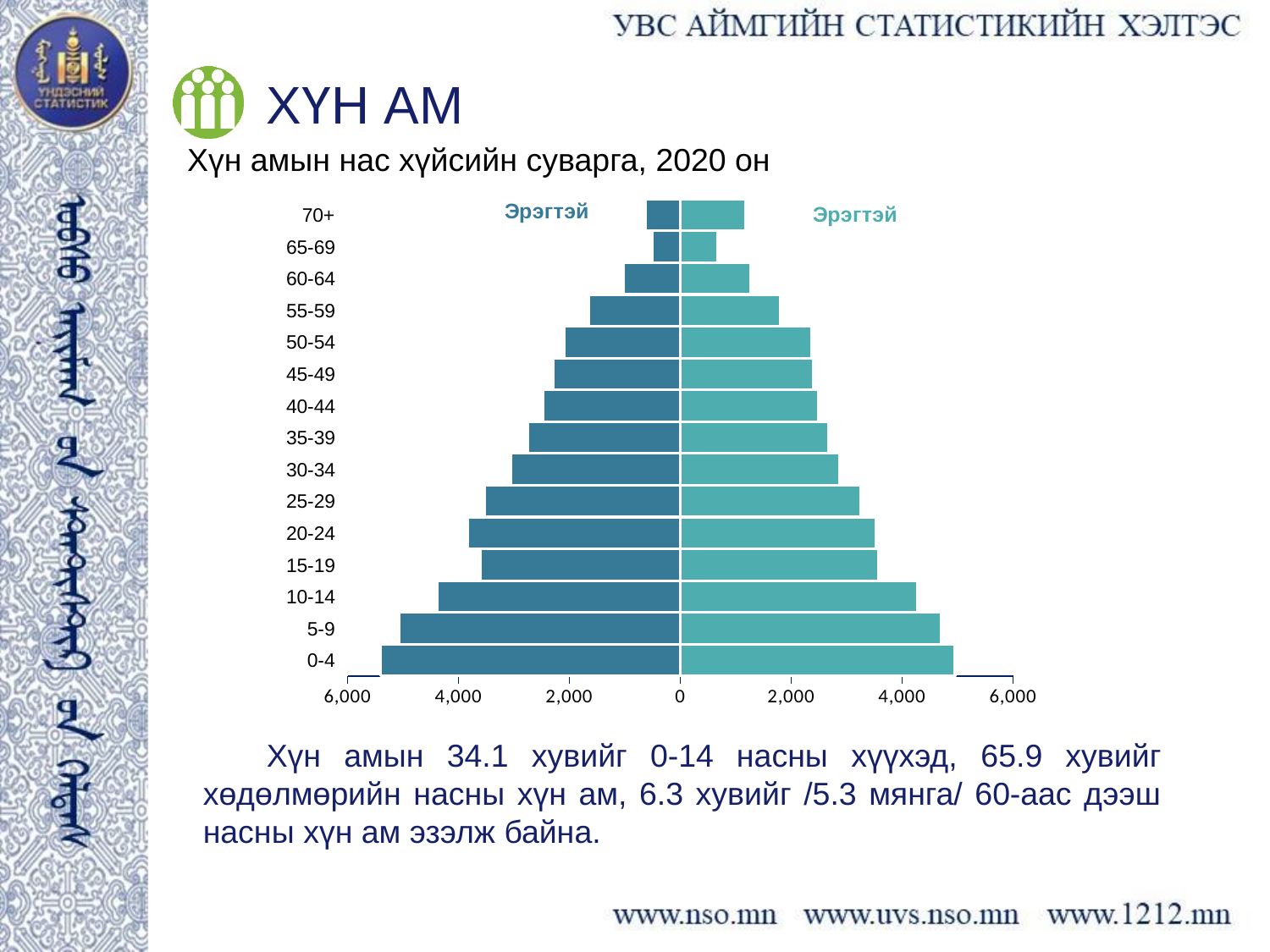
Which year is stated in the chart title? 2020 Do the bars generally get longer or shorter as the age groups increase from 0-4 to 70+? shorter What kind of chart is shown on the slide? bar chart Which age group has the shortest bar on the left (dark blue) side of the chart? 65-69 Which age group has the longest bar on the left (dark blue) side of the chart? 0-4 Is the left-side (dark blue) value for the 15-19 age group greater or less than 4,000? less Is the left-side (dark blue) value for the 70+ age group greater or less than 2,000? less Is the right-side (teal) value for the 5-9 age group greater or less than 4,000? greater Which age group has the shortest bar on the right (teal) side of the chart? 65-69 On the left (dark blue) side, which bar is longer: 0-4 or 70+? 0-4 How many age groups are shown on the vertical axis of the chart? 15